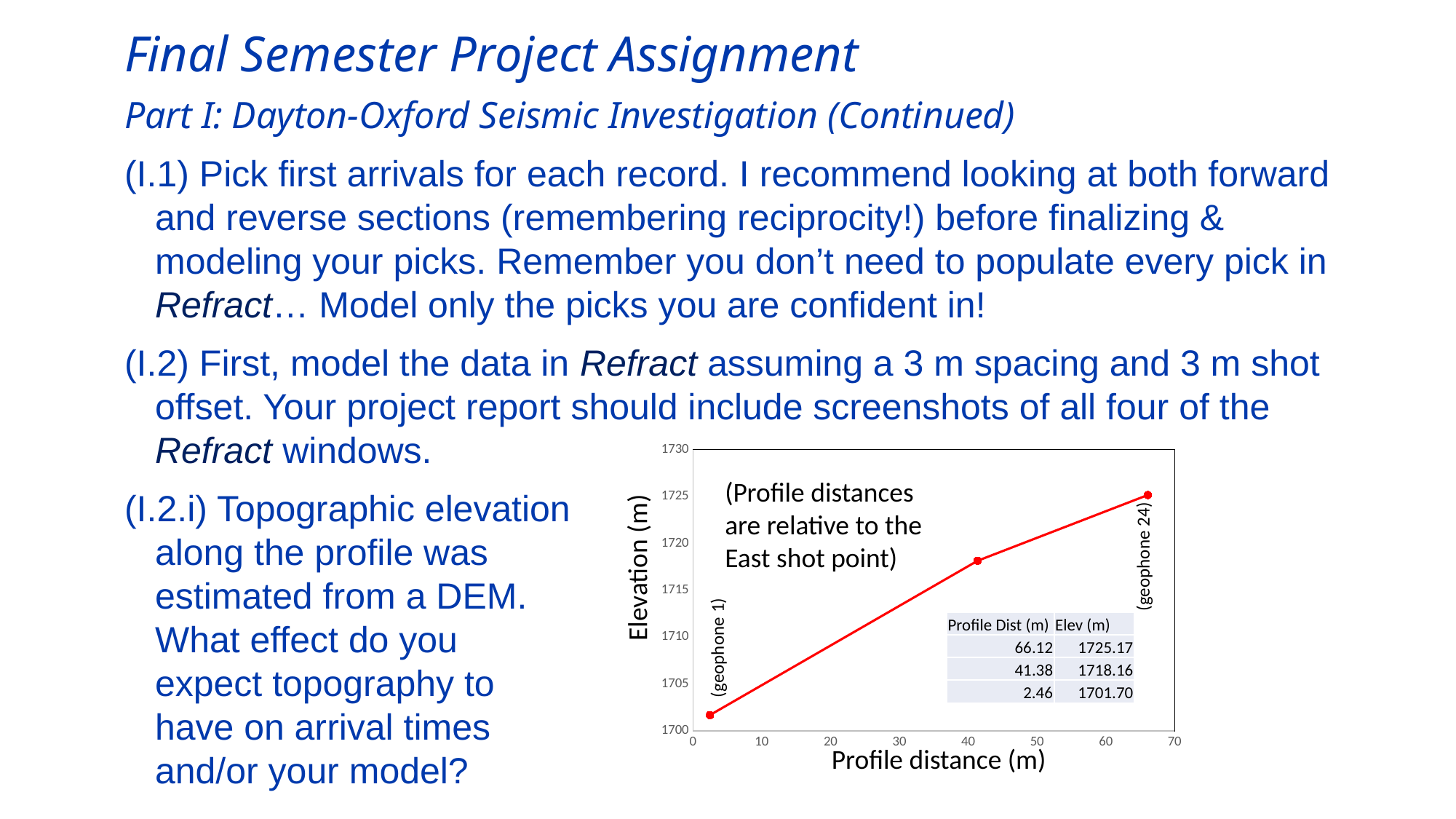
What is the difference in elevation between the points at 66.12 m and 2.46 m profile distance? 23.47 What is the elevation at a profile distance of 2.46 m? 1701.70 What is the elevation at a profile distance of 41.38 m? 1718.16 What is the elevation at a profile distance of 66.12 m? 1725.17 What is the label of the y axis of the chart? Elevation (m) What kind of chart is shown on the slide? line chart Which profile distance has the highest elevation? 66.12 How many data points are plotted on the elevation chart? 3 Which profile distance has the lowest elevation? 2.46 Which has a higher elevation: the point at 41.38 m or the point at 2.46 m? 41.38 m Is the elevation at geophone 1 greater or less than 1705? less Does elevation rise or fall as profile distance increases along the x axis? rise